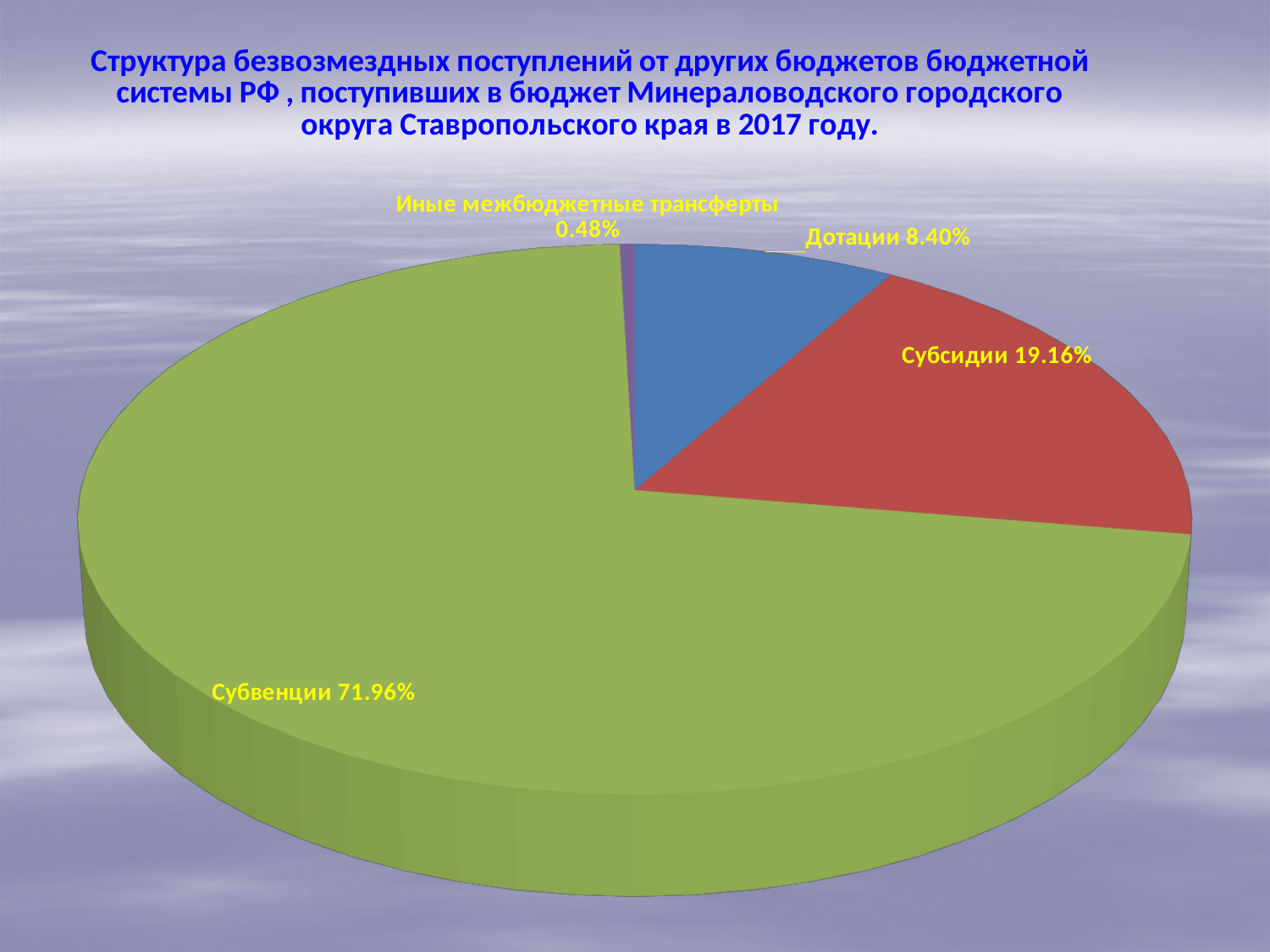
What share of the pie does Субвенции have? 71.96% What colour is the Субсидии slice? Red Which category has the largest share of the pie? Субвенции What share of the pie does Дотации have? 8.40% Which is larger, the share for Дотации or the share for Субсидии? Субсидии Which category has the smallest share of the pie? Иные межбюджетные трансферты What is the difference in percentage points between Субсидии and Дотации? 10.76 What share of the pie does Субсидии have? 19.16% What share of the pie does Иные межбюджетные трансферты have? 0.48% What is the difference in percentage points between Субвенции and Субсидии? 52.80 How many categories are shown in the pie chart? 4 What kind of chart is shown on the slide? Pie chart